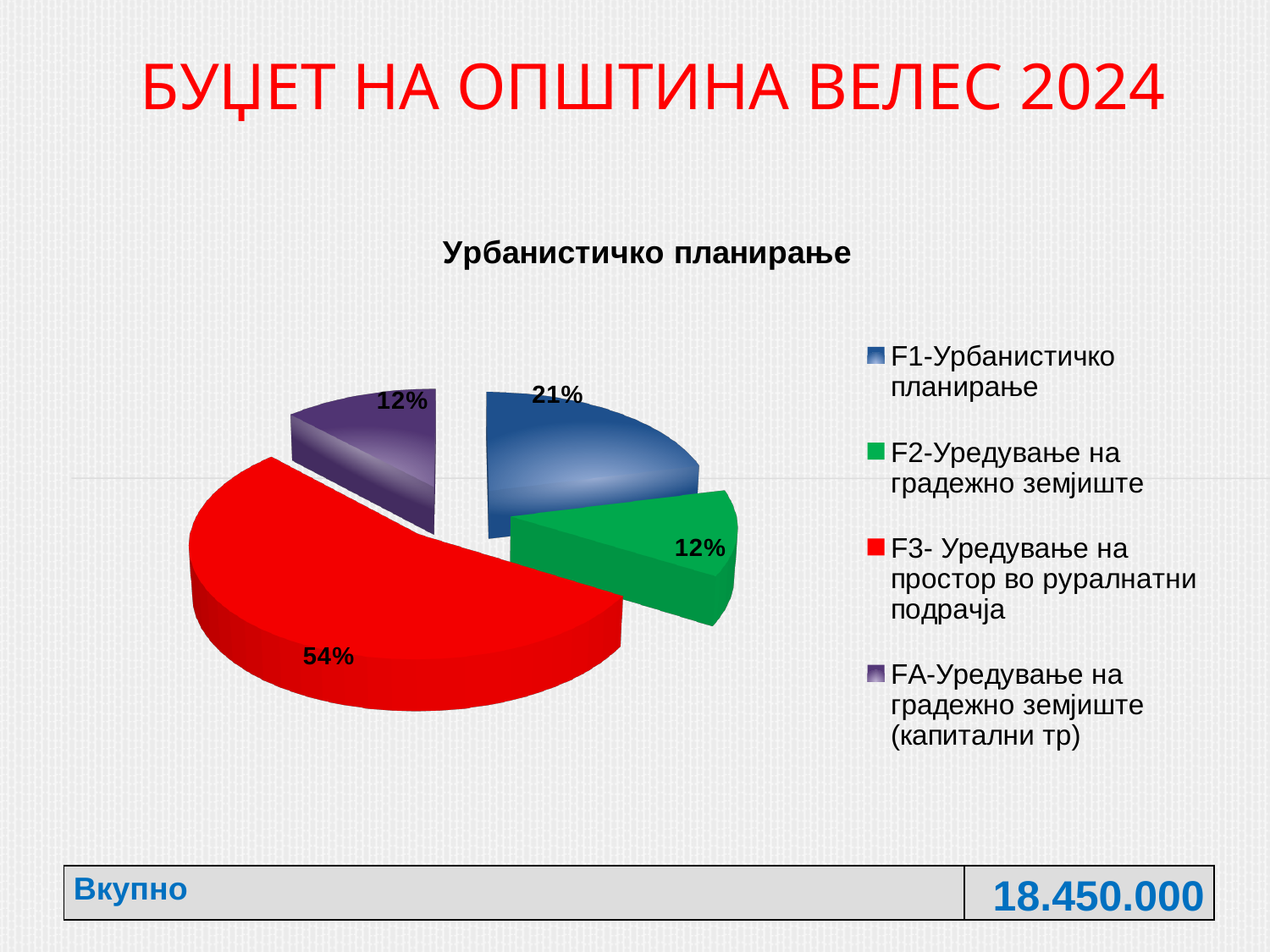
What kind of chart is shown on the slide? pie chart What is the percentage shown for F1-Урбанистичко планирање? 21% Which is larger, the slice for F1-Урбанистичко планирање or the slice for F2-Уредување на градежно земјиште? F1-Урбанистичко планирање What share of the pie does FA-Уредување на градежно земјиште (капитални тр) take? 12% What is the title of the pie chart? Урбанистичко планирање How many slices does the pie chart have? 4 What is the percentage shown for F2-Уредување на градежно земјиште? 12% By how many percentage points does the F3 slice exceed the F1 slice? 33 percentage points What colour is the slice for F3- Уредување на простор во руралнатни подрачја? red Which category has the largest slice of the pie? F3- Уредување на простор во руралнатни подрачја By how many percentage points does the F1 slice exceed the F2 slice? 9 percentage points What share of the pie does F3- Уредување на простор во руралнатни подрачја take? 54%